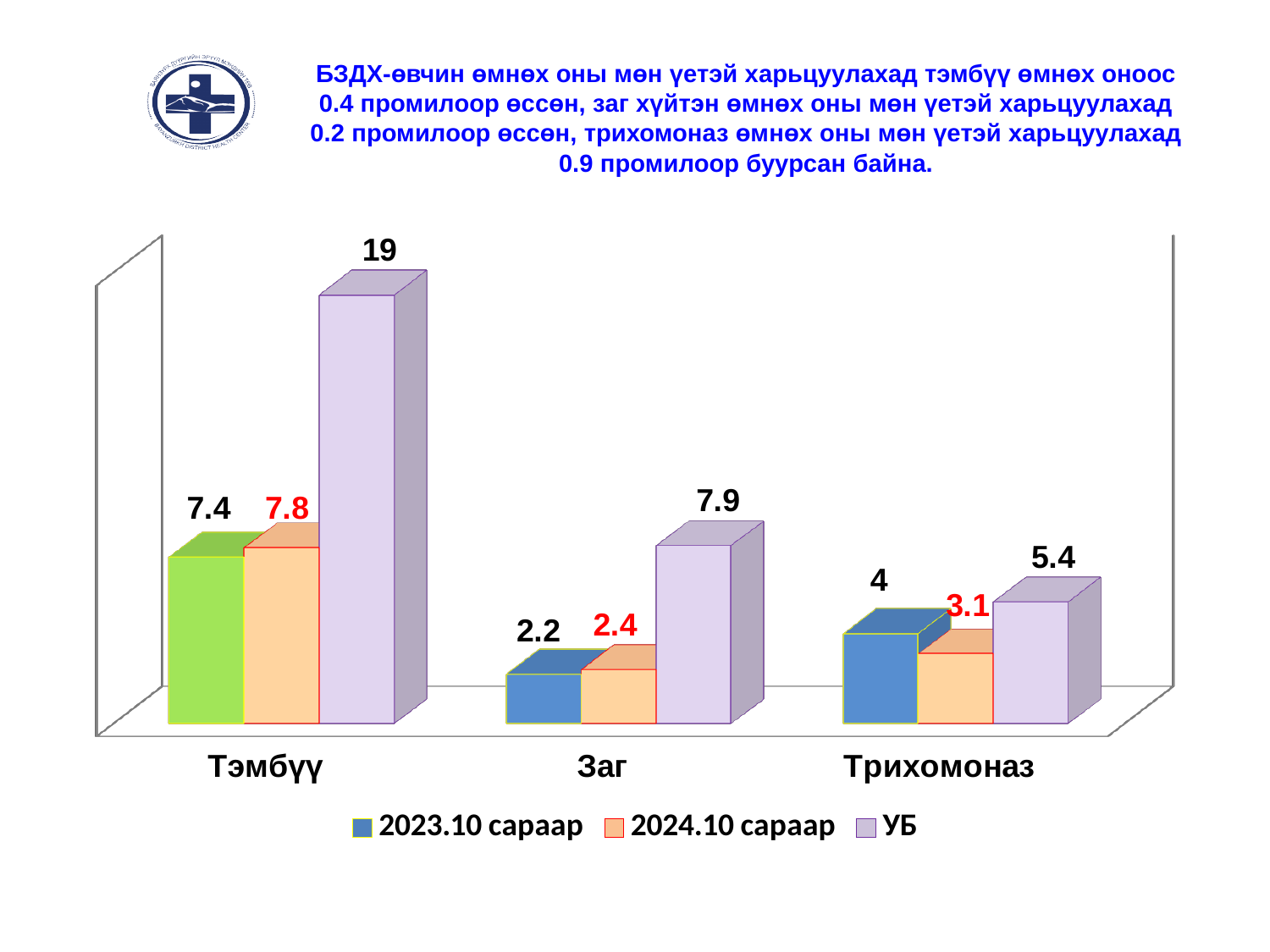
What is the value for Тэмбүү in the 2023.10 сараар series? 7.4 What is the УБ value for Заг? 7.9 For Трихомоназ, which is larger: the 2023.10 сараар value or the 2024.10 сараар value? 2023.10 сараар How many categories are shown on the x axis? 3 What is the value for Тэмбүү in the 2024.10 сараар series? 7.8 Which category has the lowest value in the 2023.10 сараар series? Заг What is the difference between the 2023.10 сараар and 2024.10 сараар values for Трихомоназ? 0.9 What kind of chart is shown on the slide? Bar chart What is the value for Трихомоназ in the 2024.10 сараар series? 3.1 Which category has the highest УБ value? Тэмбүү What is the difference between the УБ value and the 2024.10 сараар value for Тэмбүү? 11.2 How many series does the legend list? 3